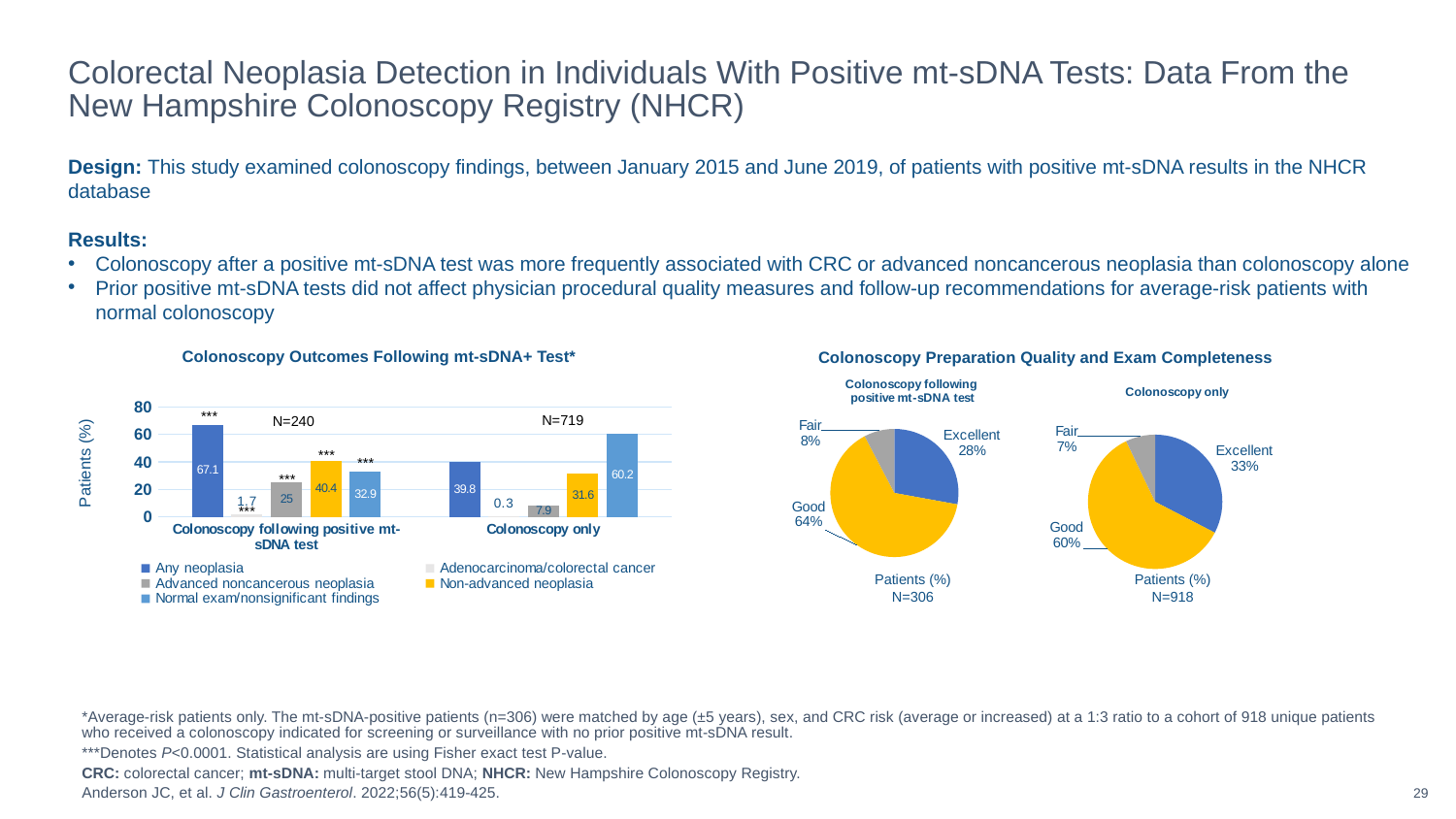
What is the N shown under the 'Colonoscopy only' pie chart? N=918 In the 'Colonoscopy Outcomes Following mt-sDNA+ Test' bar chart, what is the value for Adenocarcinoma/colorectal cancer in the Colonoscopy only group? 0.3 In the 'Colonoscopy Outcomes Following mt-sDNA+ Test' bar chart, what is the value for Normal exam/nonsignificant findings in the Colonoscopy only group? 60.2 In the 'Colonoscopy Outcomes Following mt-sDNA+ Test' bar chart, what is the difference between Any neoplasia in the Colonoscopy following positive mt-sDNA test group and Any neoplasia in the Colonoscopy only group? 27.3 How many series does the legend of the 'Colonoscopy Outcomes Following mt-sDNA+ Test' chart list? 5 What kind of chart is 'Colonoscopy Outcomes Following mt-sDNA+ Test'? Bar chart In the 'Colonoscopy Outcomes Following mt-sDNA+ Test' bar chart, which is larger: Non-advanced neoplasia in the Colonoscopy following positive mt-sDNA test group or Non-advanced neoplasia in the Colonoscopy only group? Colonoscopy following positive mt-sDNA test In the 'Colonoscopy only' pie chart, what share of patients had Excellent preparation quality? 33% In the 'Colonoscopy following positive mt-sDNA test' pie chart, what share of patients had Good preparation quality? 64% In the 'Colonoscopy Outcomes Following mt-sDNA+ Test' bar chart, which series has the lowest value in the Colonoscopy following positive mt-sDNA test group? Adenocarcinoma/colorectal cancer In the 'Colonoscopy only' pie chart, which category has the smallest slice? Fair In the 'Colonoscopy Outcomes Following mt-sDNA+ Test' bar chart, what is the value for Any neoplasia in the Colonoscopy following positive mt-sDNA test group? 67.1